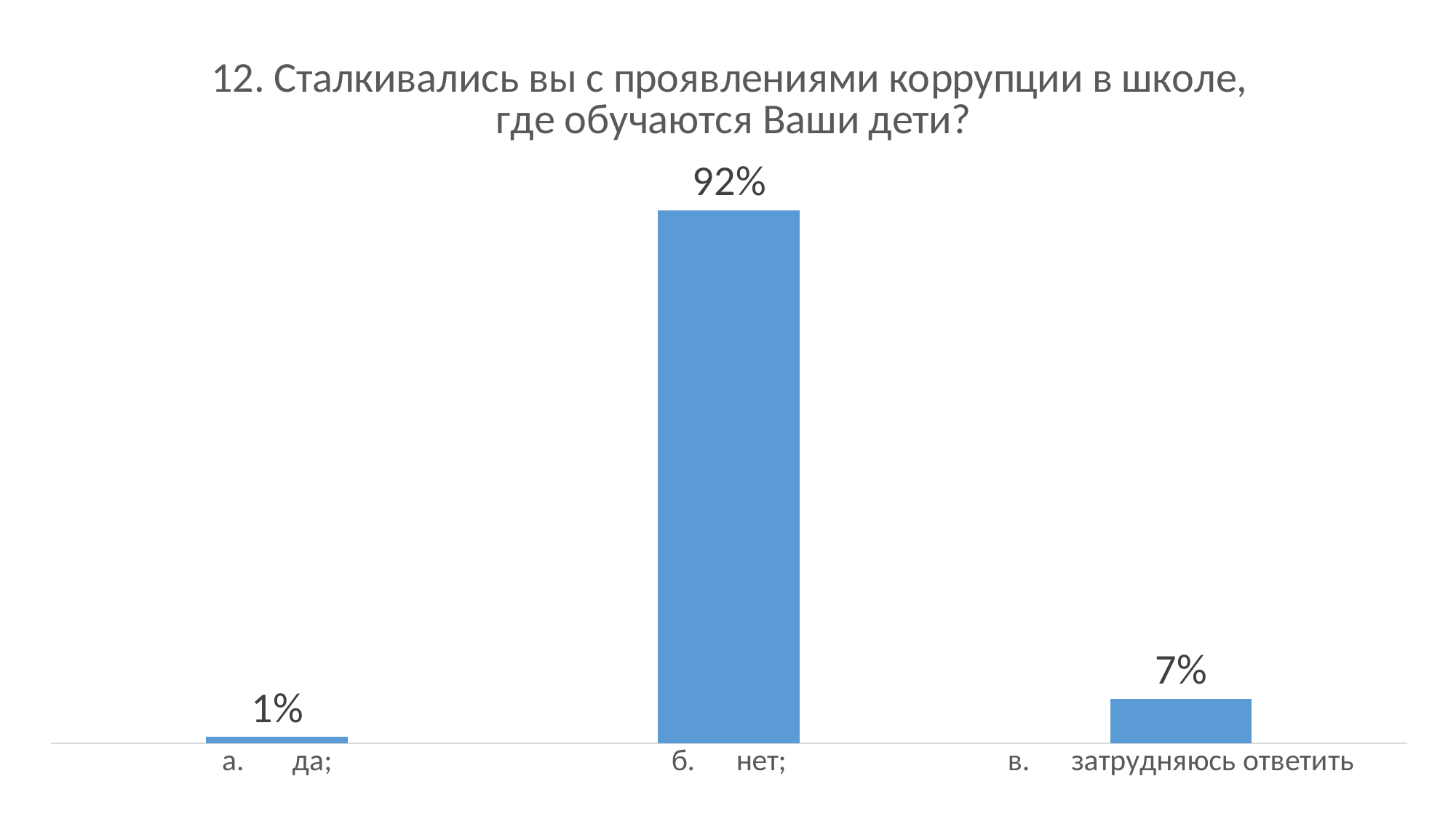
What is the difference in percentage points between "нет" and "затрудняюсь ответить"? 85 Which is larger, the value for "да" or the value for "затрудняюсь ответить"? затрудняюсь ответить Which answer option has the lowest value? да What percentage of respondents answered "нет" (no)? 92% What kind of chart is shown on the slide? bar chart What percentage of respondents answered "да" (yes)? 1% What is the number of the survey question shown in the chart title? 12 What is the total of the three percentages shown? 100% What percentage of respondents answered "затрудняюсь ответить"? 7% How many answer categories are shown in the chart? 3 What is the difference in percentage points between "затрудняюсь ответить" and "да"? 6 Which answer option has the highest value? нет